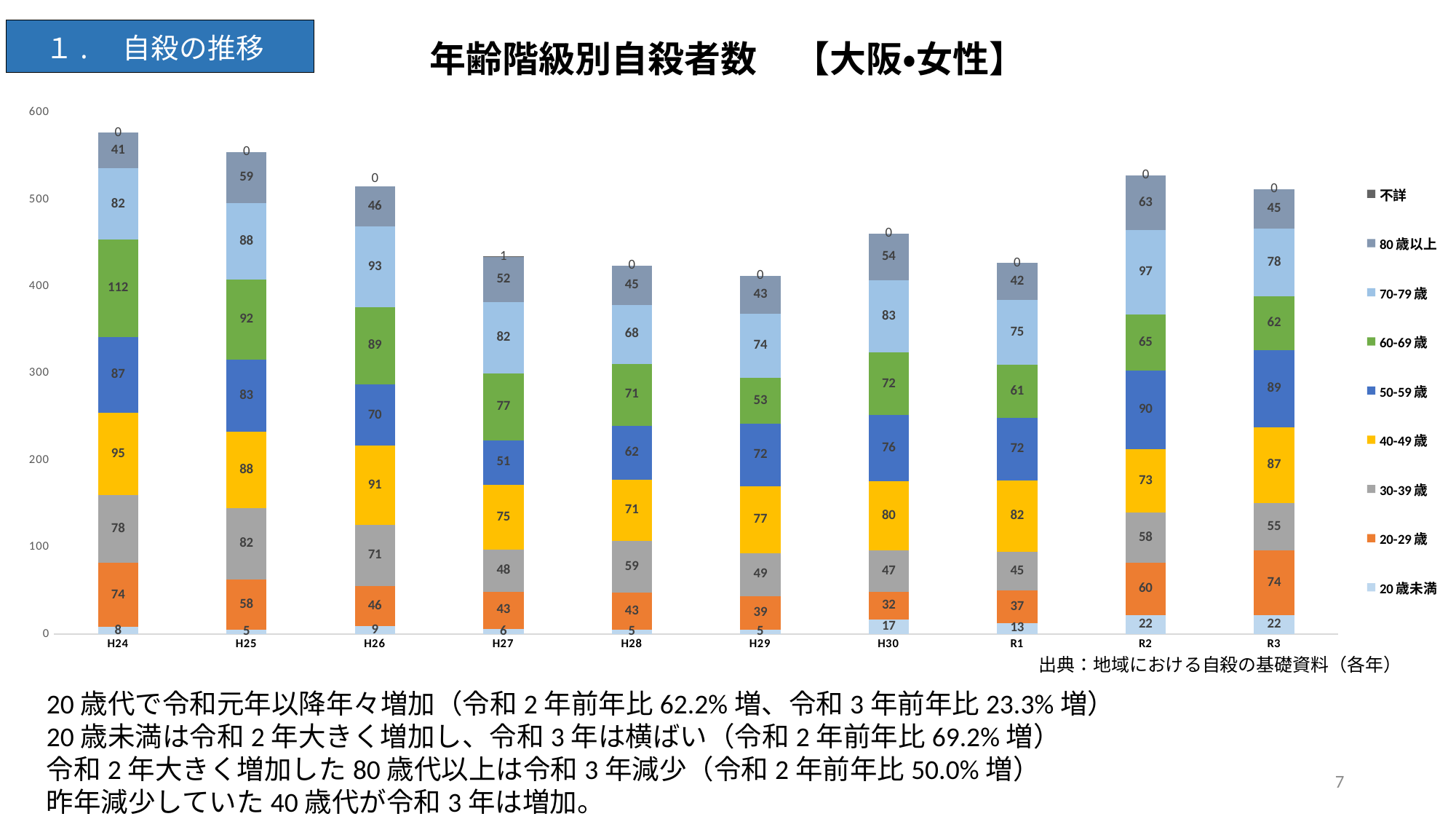
What is the value for 80歳以上 in R2? 63 In which year is the 60-69歳 value the highest? H24 How many years are shown along the x axis? 10 How many series does the legend list? 9 What is the value for 20-29歳 in R3? 74 What is the difference between the 20-29歳 values for R2 and R1? 23 Which series is listed first (at the top) in the legend? 不詳 What kind of chart is shown on the slide? stacked bar chart In which year is the 30-39歳 value the lowest? R1 What is the total of the stacked bar for H29? 412 Which is larger, the 70-79歳 value for H26 or for H27? H26 What is the value for 60-69歳 in H24? 112